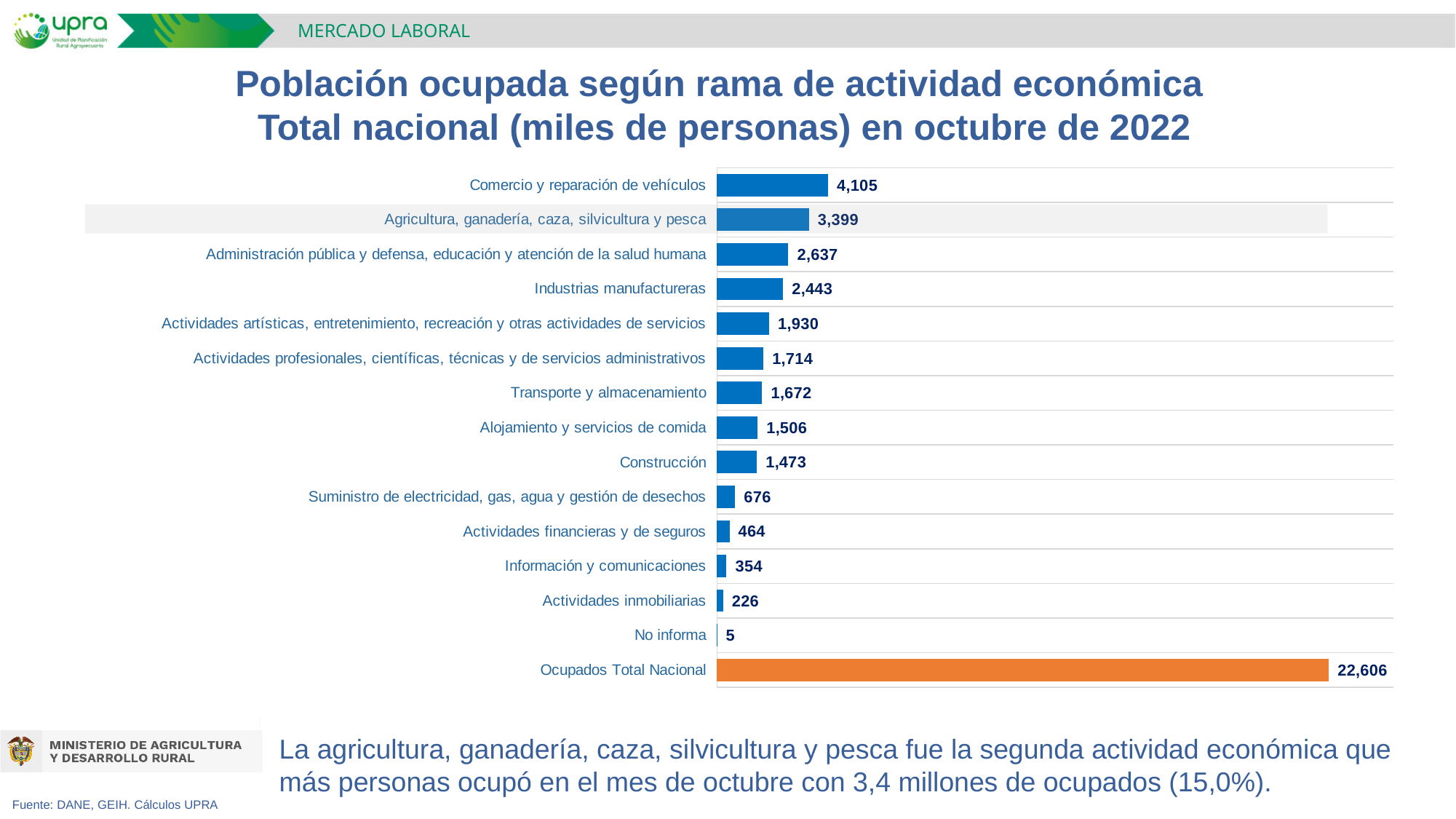
What is the difference between Administración pública y defensa, educación y atención de la salud humana and Industrias manufactureras? 194 What colour is the bar for Ocupados Total Nacional? Orange How many bars are plotted in the chart? 15 Excluding Ocupados Total Nacional, which rama de actividad has the highest value? Comercio y reparación de vehículos What is the value for Actividades inmobiliarias? 226 What is the value for Agricultura, ganadería, caza, silvicultura y pesca? 3,399 Which is larger, Transporte y almacenamiento or Alojamiento y servicios de comida? Transporte y almacenamiento What is the value for Industrias manufactureras? 2,443 What is the value for Ocupados Total Nacional? 22,606 What kind of chart is shown on the slide? Bar chart Which category has the lowest value? No informa What is the difference between Comercio y reparación de vehículos and Agricultura, ganadería, caza, silvicultura y pesca? 706